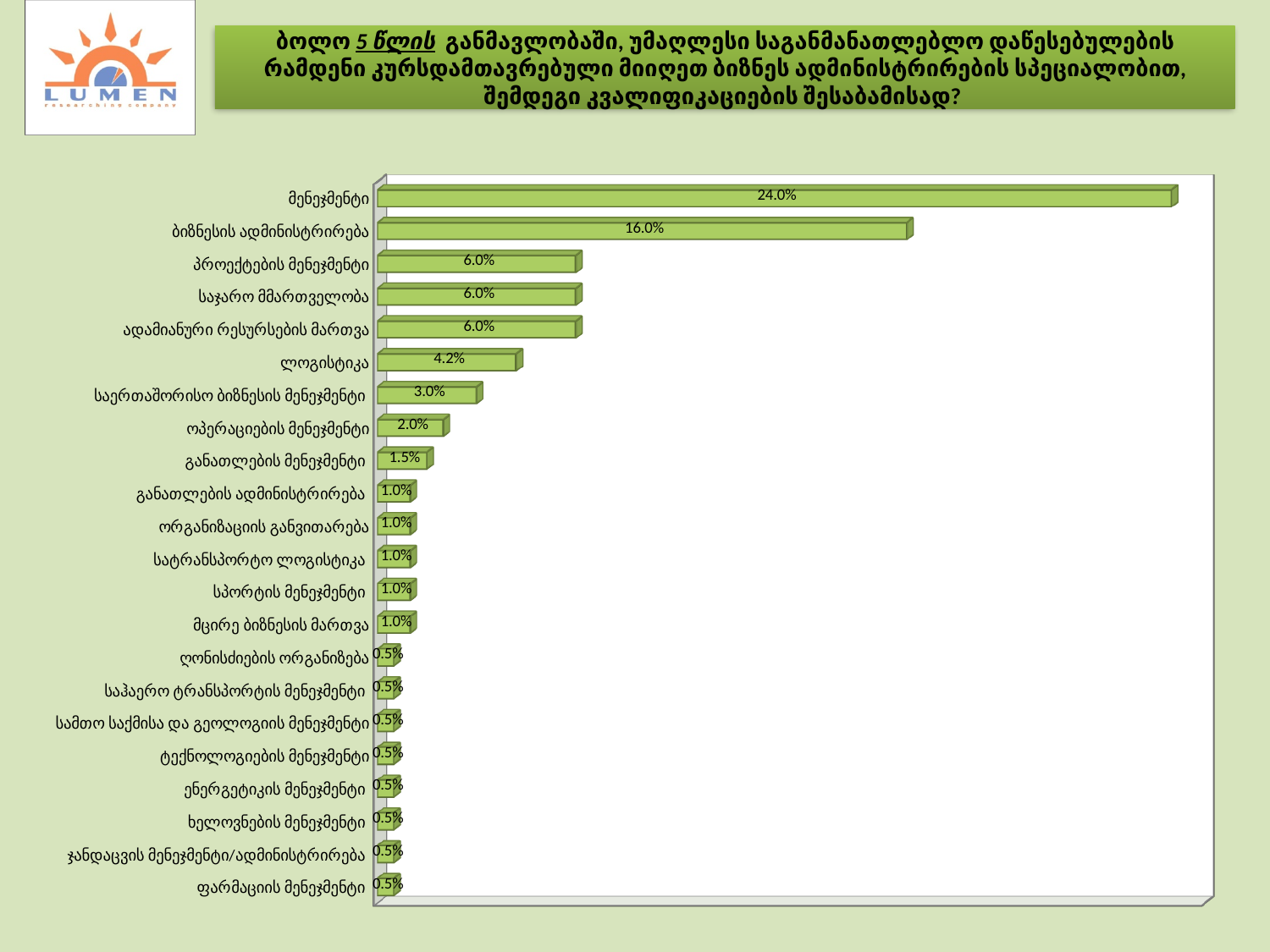
What is the difference between the values for მენეჯმენტი and ბიზნესის ადმინისტრირება? 8.0% What is the value for ბიზნესის ადმინისტრირება? 16.0% What is the value for ფარმაციის მენეჯმენტი? 0.5% What is the value for მენეჯმენტი? 24.0% Which category has the highest value? მენეჯმენტი Which is larger, the value for პროექტების მენეჯმენტი or the value for ლოგისტიკა? პროექტების მენეჯმენტი What is the value for ლოგისტიკა? 4.2% What is the value for საერთაშორისო ბიზნესის მენეჯმენტი? 3.0% What is the difference between the values for ლოგისტიკა and ოპერაციების მენეჯმენტი? 2.2% How many categories are shown in the chart? 22 What kind of chart is shown on the slide? Bar chart What is the value for განათლების მენეჯმენტი? 1.5%